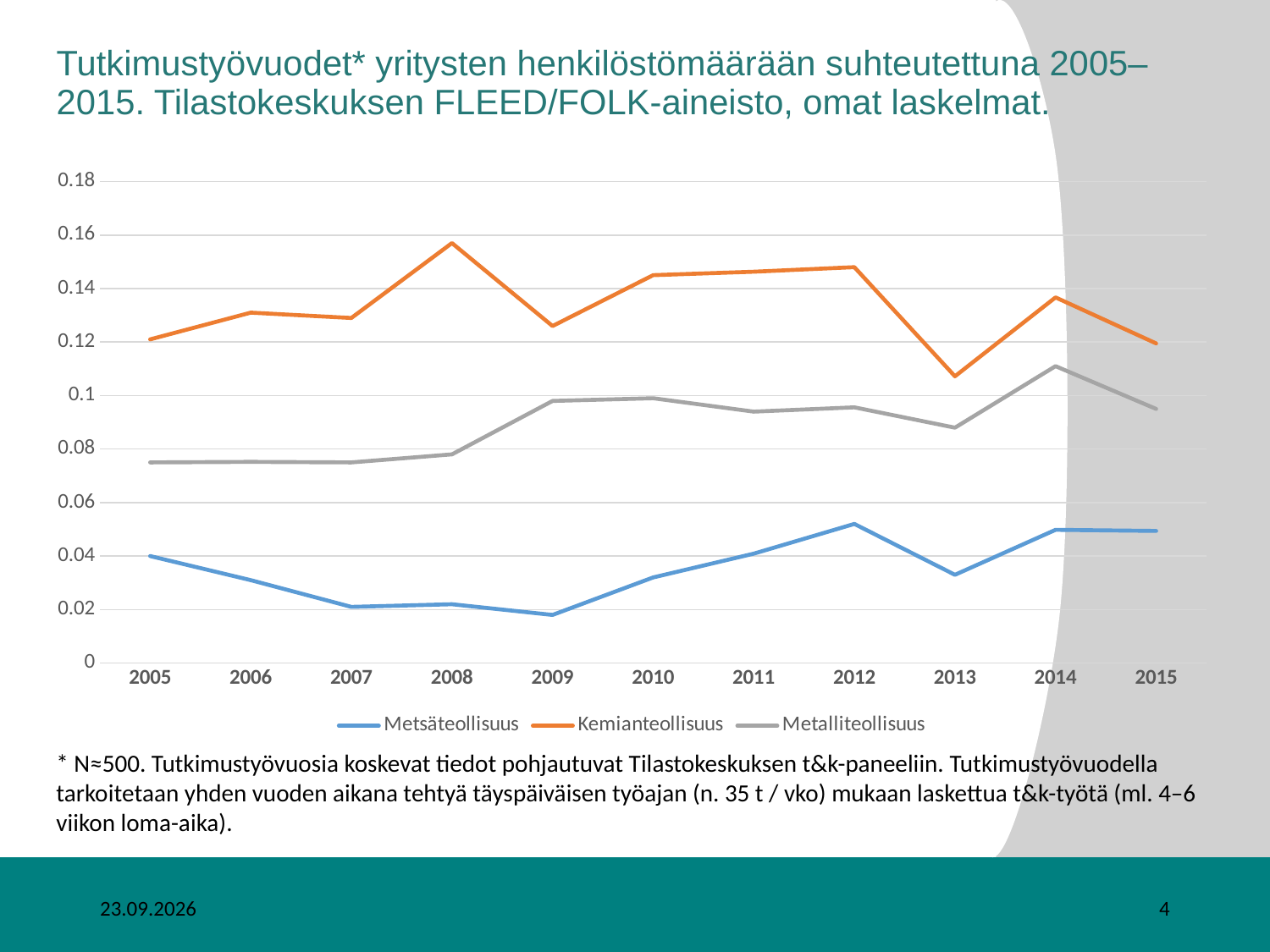
In which year does Metalliteollisuus reach its highest value? 2014 In which year does Kemianteollisuus reach its highest value? 2008 How many years are shown on the x axis? 11 How many series does the legend list? 3 In which year does Metsäteollisuus reach its lowest value? 2009 Does the Metalliteollisuus line rise or fall from 2005 to 2010? rise What kind of chart is shown on the slide? line chart Is the value for Metsäteollisuus in 2012 greater or less than 0.04? greater In which year does Kemianteollisuus reach its lowest value? 2013 In 2013, which series has the larger value, Kemianteollisuus or Metalliteollisuus? Kemianteollisuus Is the value for Metalliteollisuus in 2005 greater or less than 0.08? less Is the value for Kemianteollisuus in 2008 greater or less than 0.14? greater